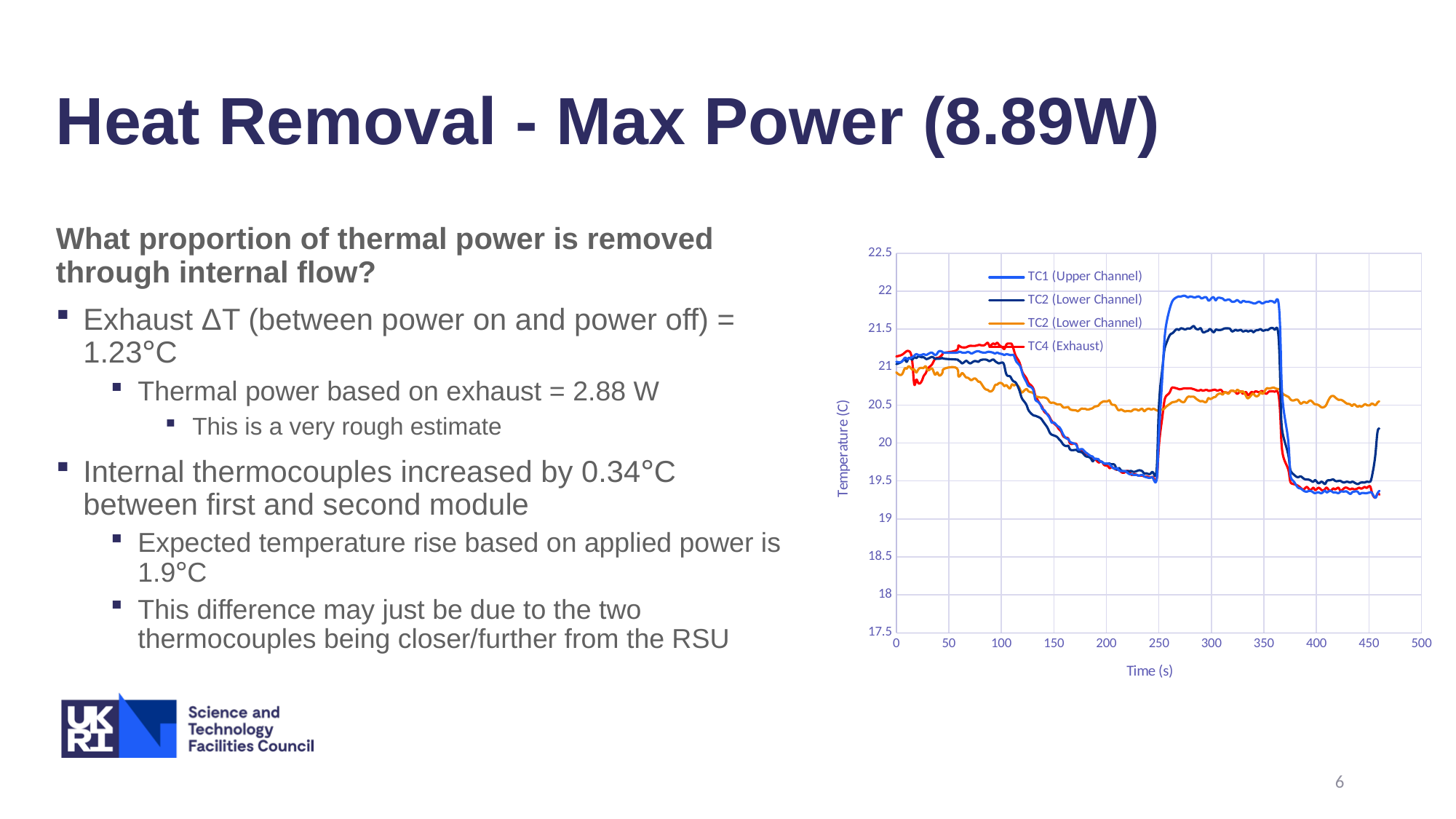
How many series does the chart legend list? 4 Is the value of TC4 (Exhaust) at time 300 s greater or less than 21? less At time 300 s, which is higher: TC1 (Upper Channel) or the orange TC2 (Lower Channel) series? TC1 (Upper Channel) Is the value of TC1 (Upper Channel) at time 400 s greater or less than 20? less What is the title of the x axis of the chart? Time (s) Between time 100 s and 250 s, does the TC1 (Upper Channel) temperature rise or fall? fall Is the value of TC1 (Upper Channel) at time 50 s greater or less than 20.5? greater What kind of chart is shown on the slide? line chart At time 300 s, which series has the highest temperature? TC1 (Upper Channel) What is the title of the y axis of the chart? Temperature (C)